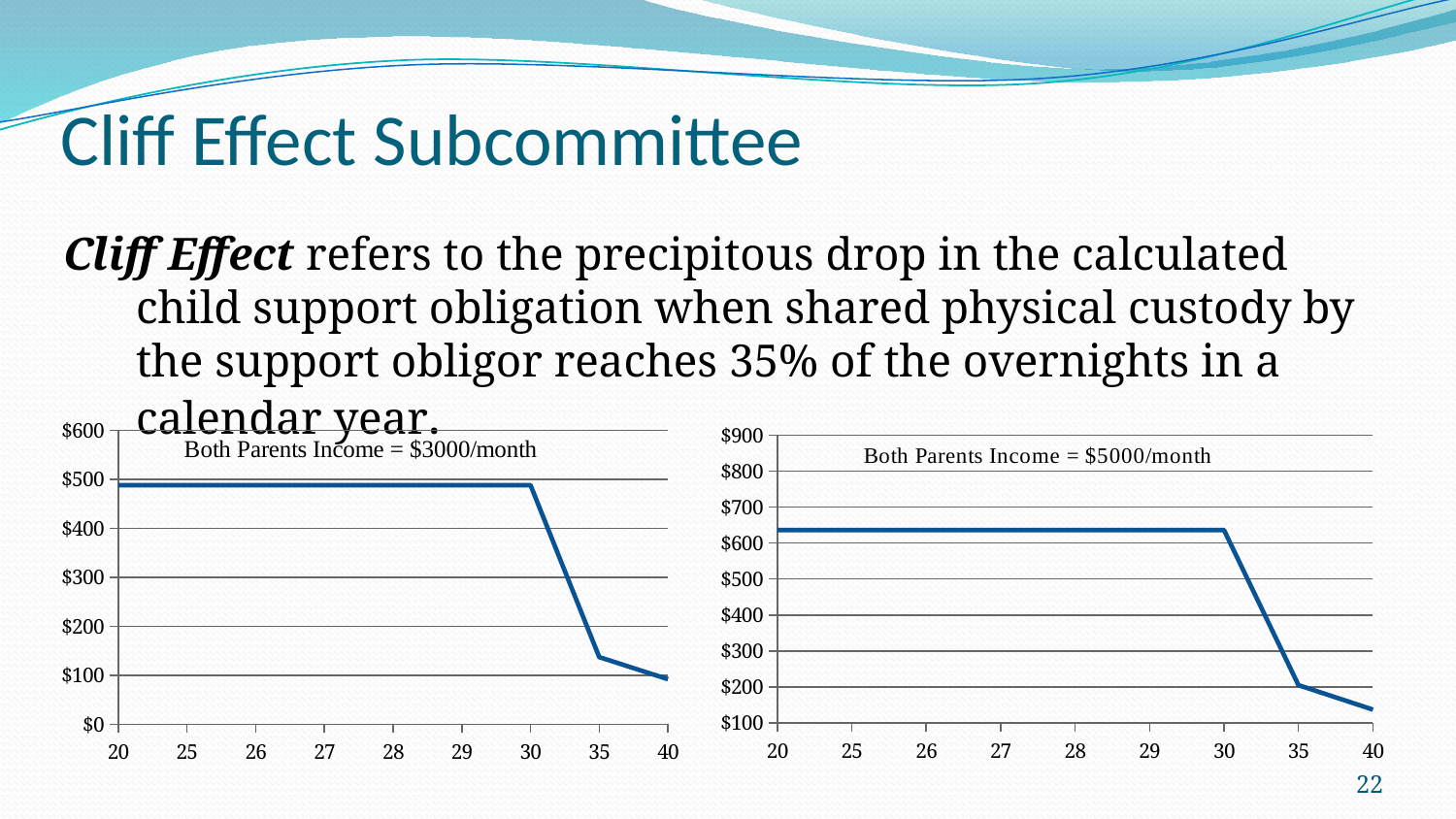
What kind of chart is the right chart titled 'Both Parents Income = $5000/month'? line chart In the right chart (Both Parents Income = $5000/month), is the value at 30 greater or less than $600? greater In the left chart (Both Parents Income = $3000/month), is the value at 35 greater or less than $200? less In the left chart (Both Parents Income = $3000/month), is the value at 25 greater or less than $400? greater In the right chart (Both Parents Income = $5000/month), do the values rise or fall between 30 and 40 on the x axis? fall In the left chart (Both Parents Income = $3000/month), which x-axis category has the lowest value? 40 In the left chart (Both Parents Income = $3000/month), how many x-axis categories are shown? 9 What kind of chart is the left chart titled 'Both Parents Income = $3000/month'? line chart What is the title of the right chart? Both Parents Income = $5000/month In the right chart (Both Parents Income = $5000/month), how many x-axis categories are shown? 9 In the right chart (Both Parents Income = $5000/month), which is larger, the value at 30 or the value at 35? 30